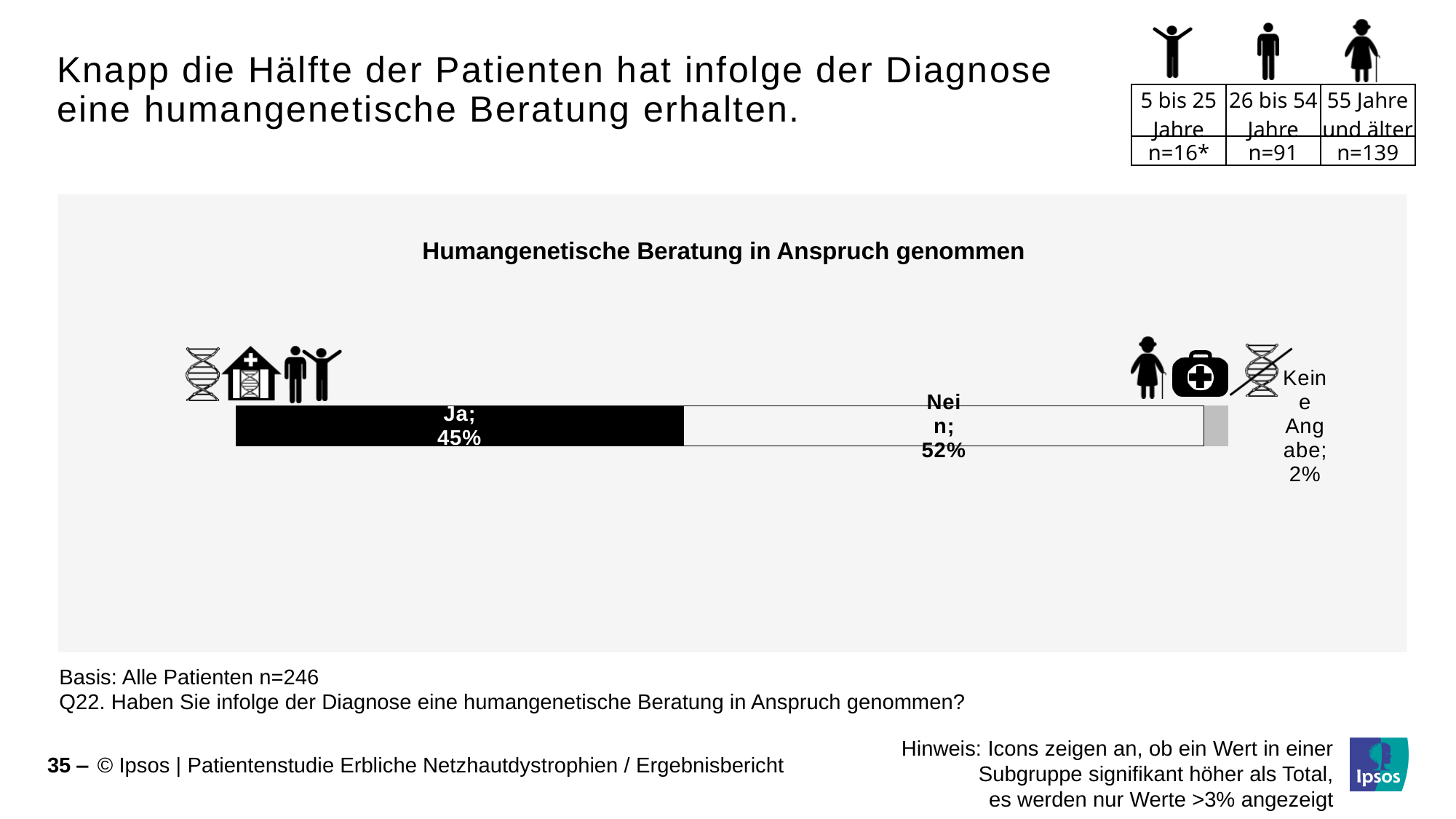
What is the combined share of "Ja" and "Nein" in the chart? 97% Which response category has the smallest share in the chart? Keine Angabe What kind of chart is shown on the slide? Stacked bar chart What percentage of patients answered "Ja" in the chart? 45% What colour is the "Ja" segment of the bar? Black Which is larger, the share for "Ja" or the share for "Nein"? Nein What percentage is shown for "Keine Angabe" in the chart? 2% What percentage of patients answered "Nein" in the chart? 52% Which response category has the largest share in the chart? Nein How many response categories are shown in the bar? 3 What is the title of the chart? Humangenetische Beratung in Anspruch genommen What is the difference in percentage points between "Nein" and "Ja"? 7